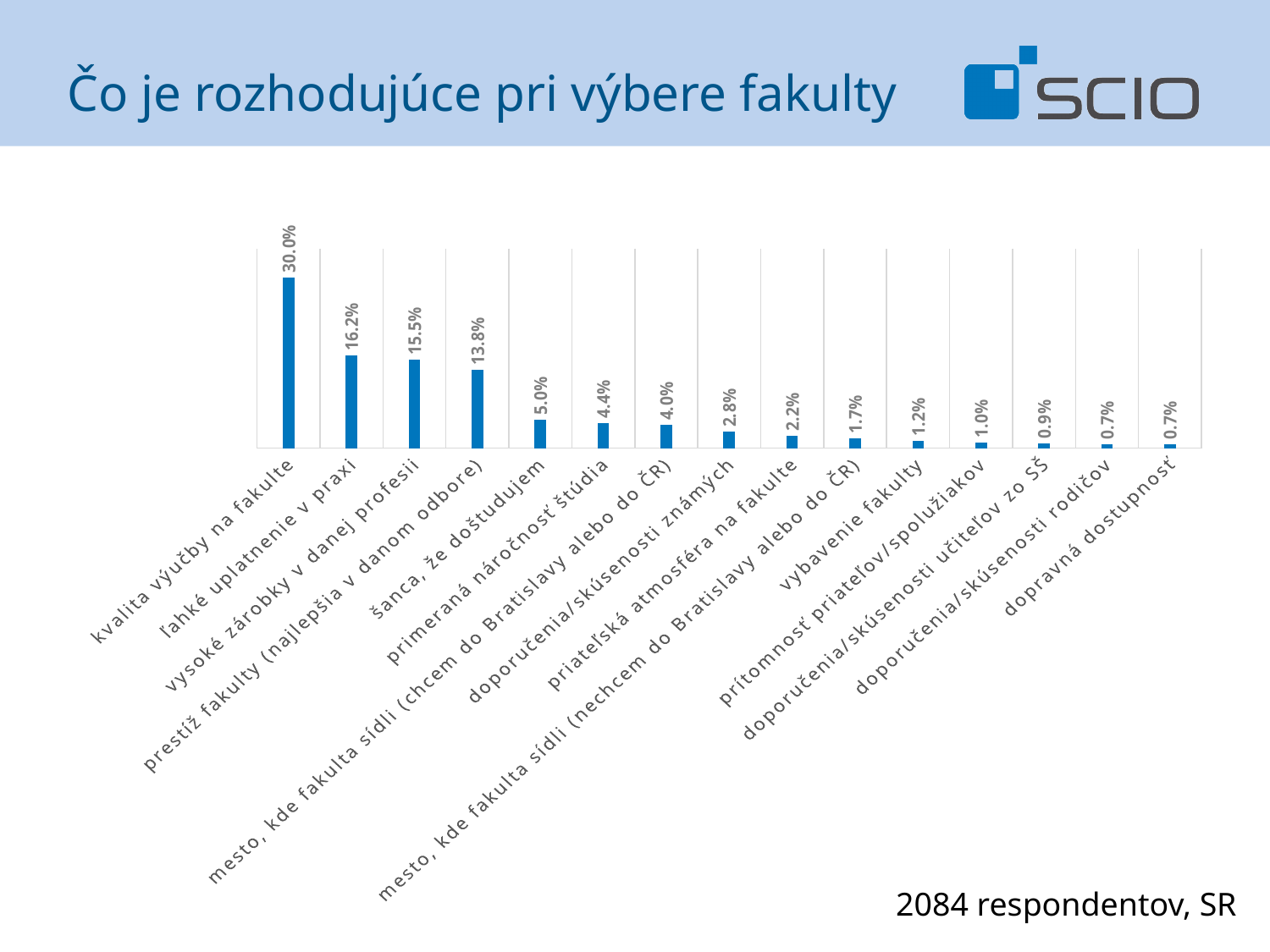
What kind of chart is shown on the slide? bar chart What is the difference between the values for "vysoké zárobky v danej profesii" and "prestíž fakulty (najlepšia v danom odbore)"? 1.7% How many categories are shown in the chart? 15 What is the value for "kvalita výučby na fakulte"? 30.0% What is the difference between the values for "kvalita výučby na fakulte" and "ľahké uplatnenie v praxi"? 13.8% Which is larger, the value for "primeraná náročnosť štúdia" or the value for "doporučenia/skúsenosti známych"? primeraná náročnosť štúdia What is the title of the slide? Čo je rozhodujúce pri výbere fakulty What is the value for "vybavenie fakulty"? 1.2% Which category has the highest value? kvalita výučby na fakulte What is the value for "šanca, že doštudujem"? 5.0% What is the value for "prestíž fakulty (najlepšia v danom odbore)"? 13.8% What is the value for "ľahké uplatnenie v praxi"? 16.2%